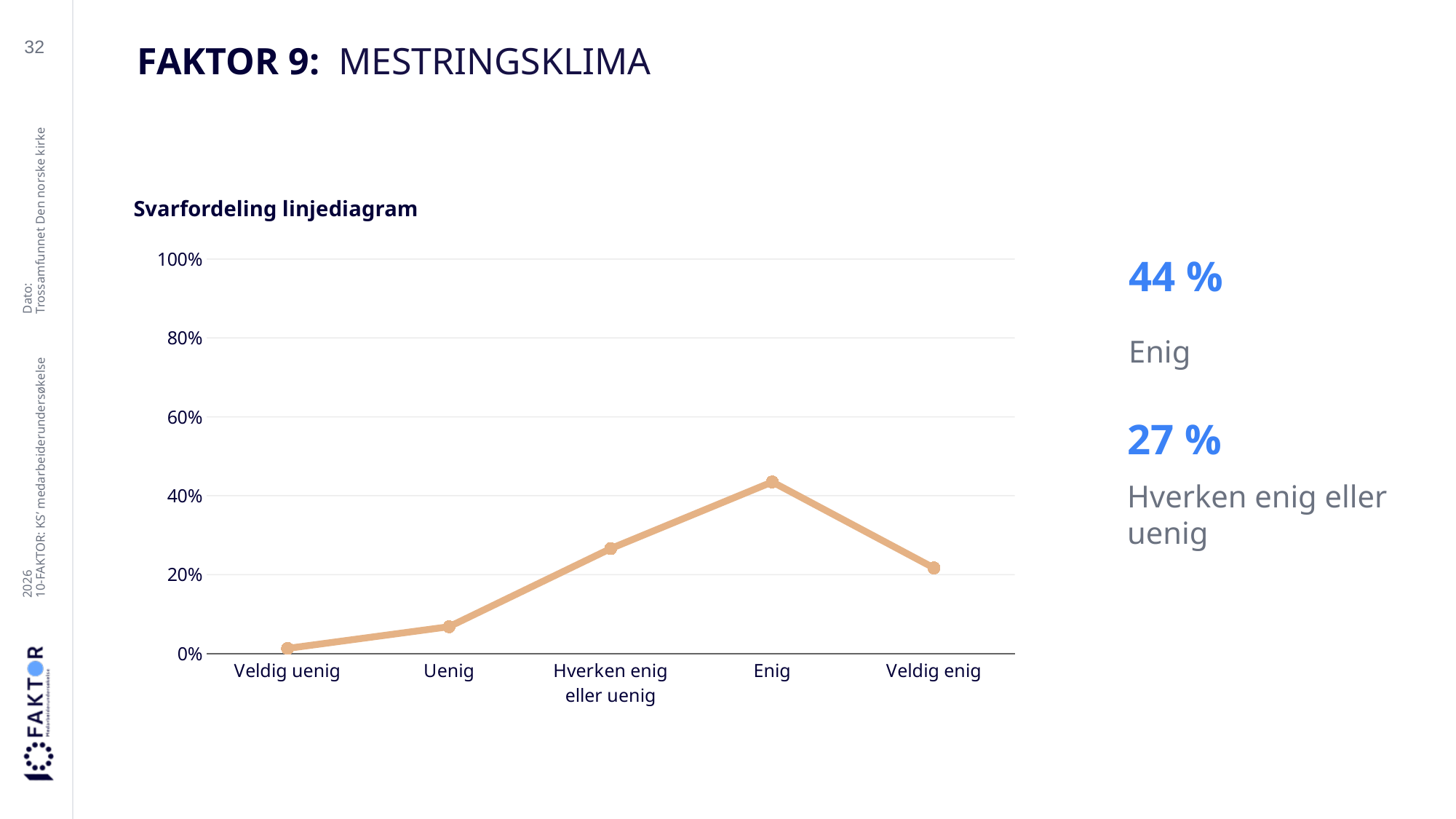
Which category has the lowest value in the chart? Veldig uenig How many categories are plotted along the x axis of the chart? 5 Do the values rise or fall from Veldig uenig to Enig? rise What kind of chart is shown on the slide? line chart Is the value for Veldig enig greater or less than 40%? less What is the value for Enig? 44 % Which is larger, the value for Enig or the value for Veldig enig? Enig Is the value for Uenig greater or less than 20%? less Which category has the highest value in the chart? Enig What is the difference between the values for Enig and Hverken enig eller uenig? 17 % What is the title of the chart? Svarfordeling linjediagram What is the value for Hverken enig eller uenig? 27 %